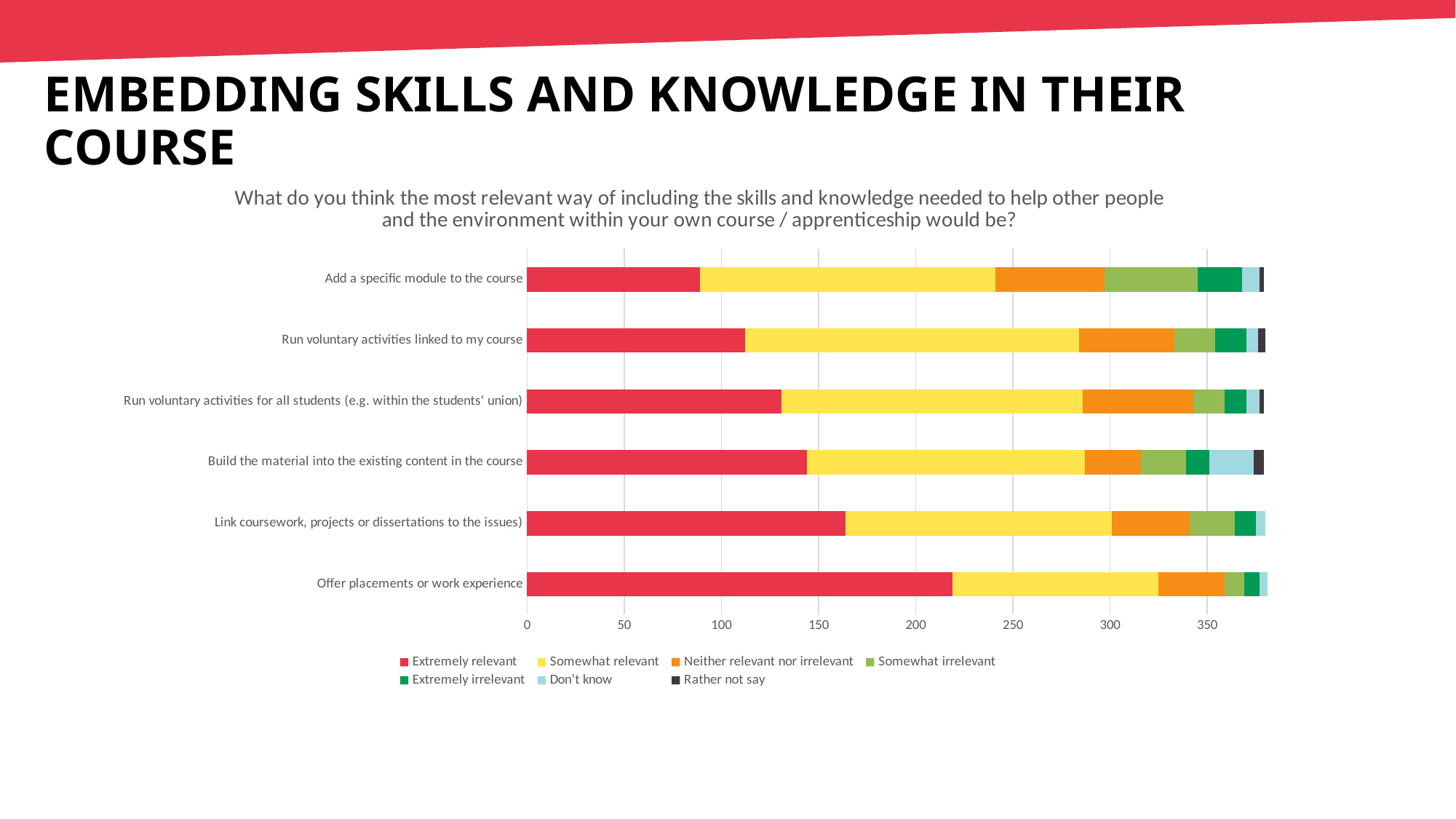
What is the highest value labelled on the horizontal axis? 350 How many categories (response options) are plotted on the chart? 6 Which category has the smallest 'Extremely relevant' segment? Add a specific module to the course Which legend entry is shown in yellow? Somewhat relevant How many series does the legend list? 7 Is the 'Extremely relevant' value for 'Add a specific module to the course' greater or less than 100? less What kind of chart is shown on the slide? Stacked bar chart Is the 'Extremely relevant' value for 'Link coursework, projects or dissertations to the issues)' greater or less than 150? greater Is the 'Extremely relevant' value for 'Run voluntary activities linked to my course' greater or less than 100? greater Which has a larger 'Extremely relevant' segment: 'Link coursework, projects or dissertations to the issues)' or 'Build the material into the existing content in the course'? Link coursework, projects or dissertations to the issues) Which category has the largest 'Extremely relevant' segment? Offer placements or work experience